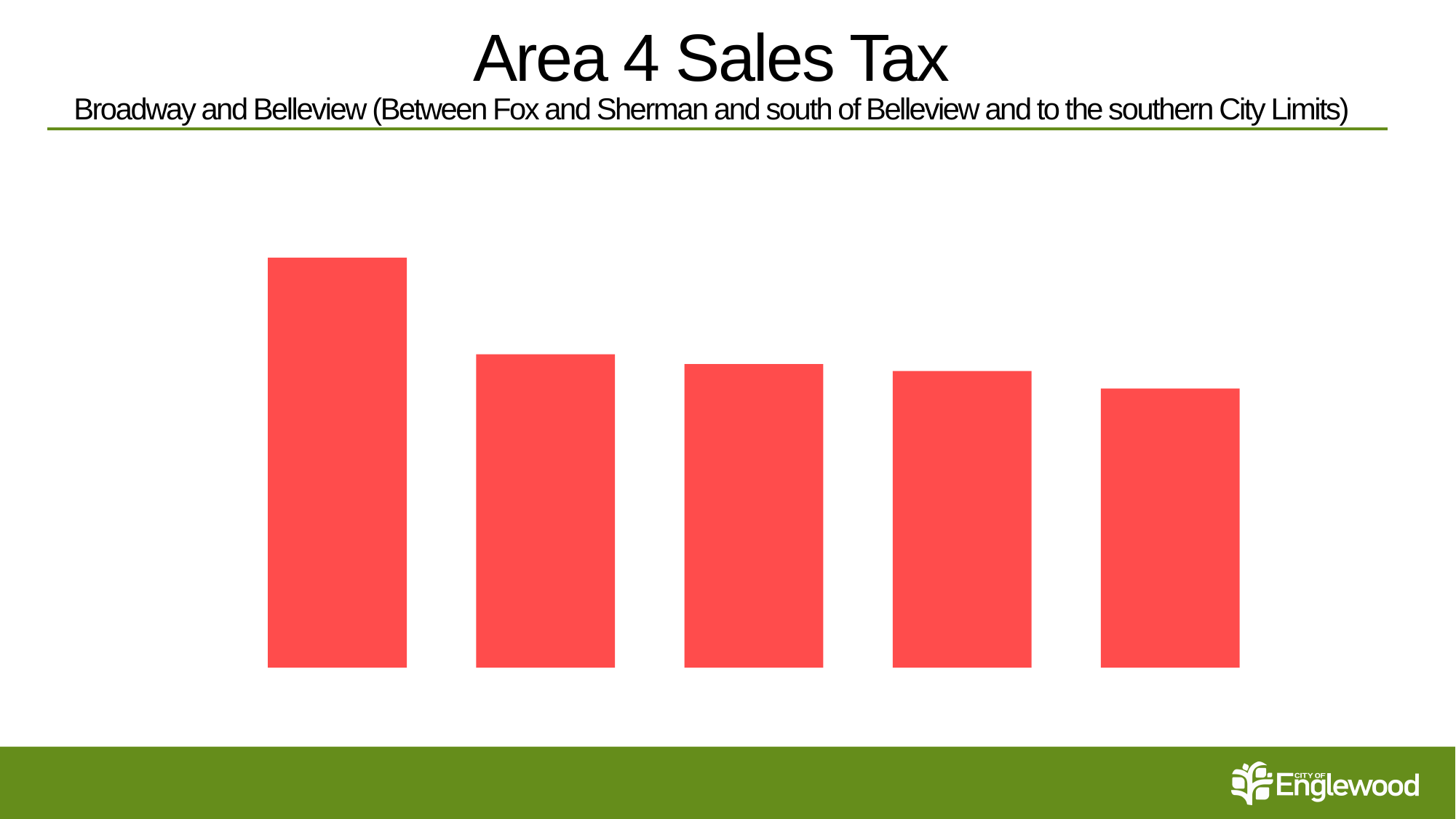
What colour are the bars in the chart? red Which is taller, the second bar or the fourth bar? the second bar Which bar is the shortest in the chart? the rightmost (fifth) bar Which is taller, the fourth bar or the fifth bar? the fourth bar What kind of chart is shown on the slide? bar chart How many bars are plotted in the chart? 5 Which is taller, the first bar or the second bar? the first bar Which bar is the tallest in the chart? the leftmost (first) bar Do the bar heights rise or fall from left to right across the chart? fall What is the title of the slide containing the chart? Area 4 Sales Tax